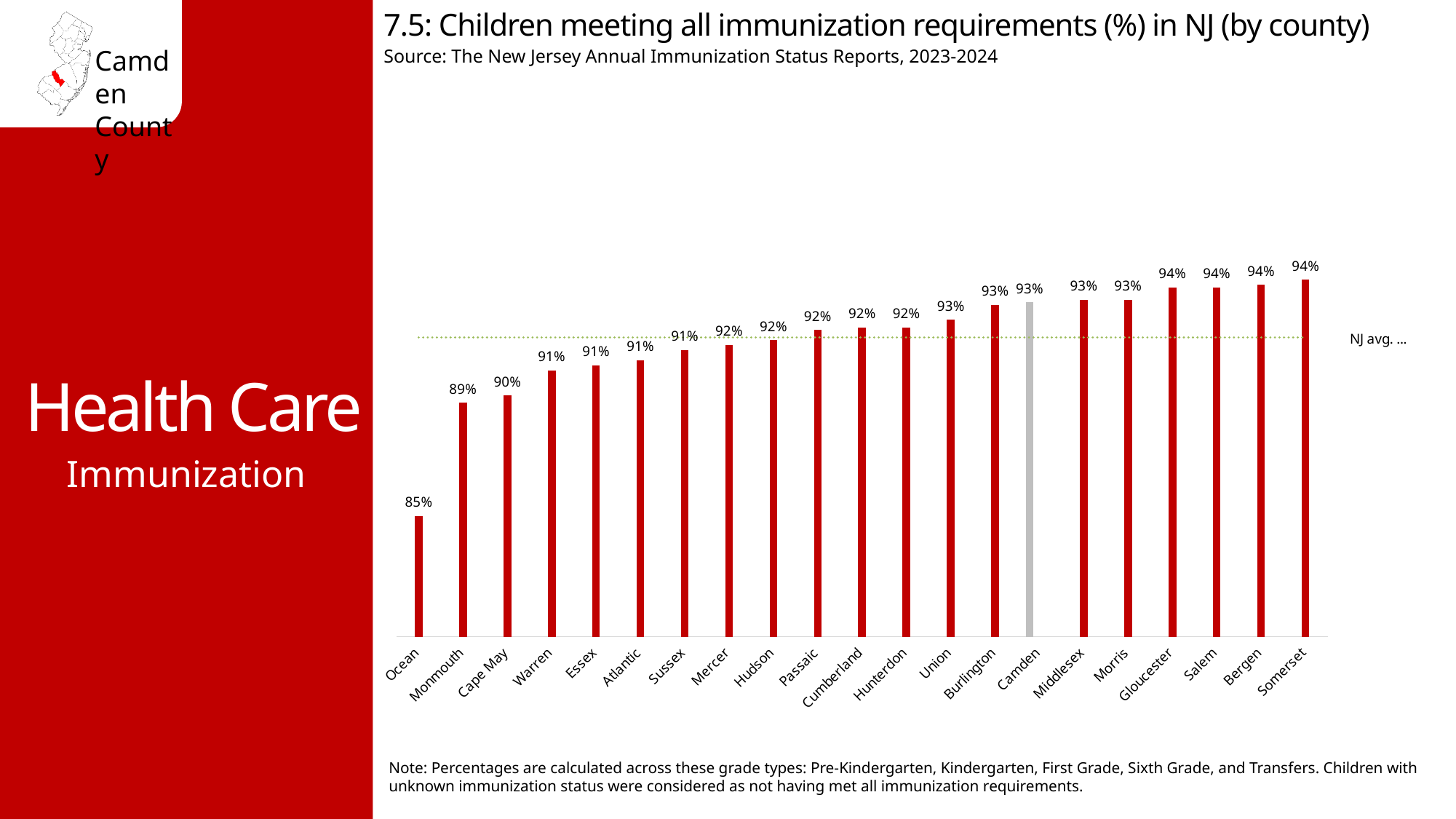
What is the difference in percentage points between Camden (93%) and Ocean (85%)? 8 percentage points How many counties are shown on the chart? 21 Which county's bar is coloured grey instead of red? Camden What percentage is shown for Monmouth County? 89% What is the value shown for Ocean County? 85% What percentage is shown for Somerset County? 94% What percentage of children in Camden County met all immunization requirements? 93% Which county has a higher value, Ocean or Somerset? Somerset What is the value for Cape May? 90% Which county has the lowest percentage of children meeting all immunization requirements? Ocean Do the values generally rise or fall moving from left to right across the counties? Rise What kind of chart is shown on the slide? Bar chart